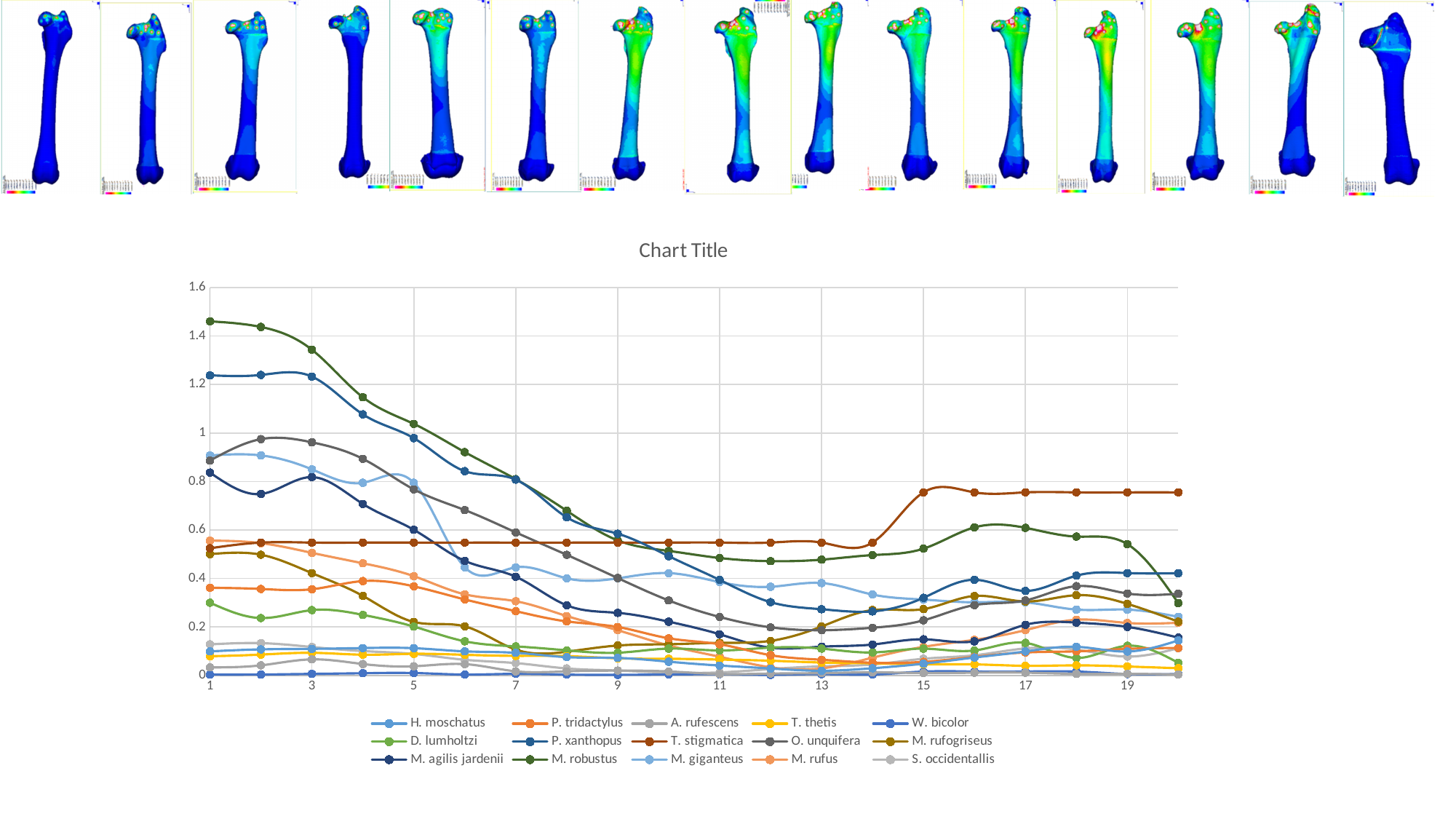
Which series has the lowest value at x = 1? W. bicolor What is the title of the chart? Chart Title Is the value for M. robustus at x = 1 greater or less than 1.4? greater Which series has the highest value at x = 1? M. robustus How many series does the chart's legend list? 15 Is the value for W. bicolor at x = 1 greater or less than 0.2? less Which series has the highest value at x = 20? T. stigmatica Is the value for T. stigmatica at x = 20 greater or less than 0.6? greater At x = 20, which is larger: T. stigmatica or M. robustus? T. stigmatica What kind of chart is shown on the slide? line chart How many points along the x axis does each series in the chart have? 20 Does the M. robustus series rise or fall from x = 1 to x = 13? fall